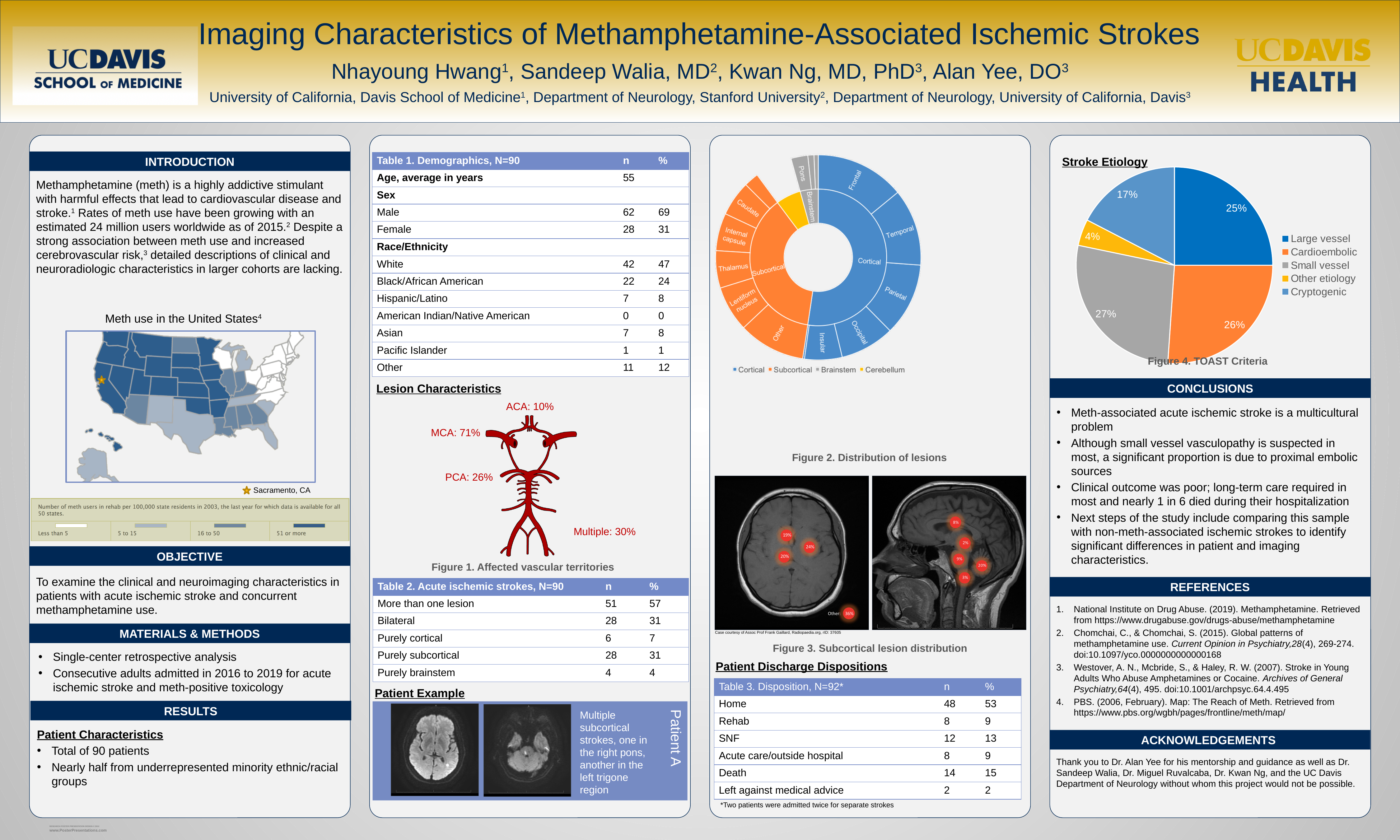
In the Stroke Etiology pie chart (Figure 4), which is larger, Cryptogenic or Other etiology? Cryptogenic How many categories does the legend of the Stroke Etiology pie chart (Figure 4) list? 5 In the Stroke Etiology pie chart (Figure 4), what share is Large vessel? 25% In Figure 2 (Distribution of lesions), which inner-ring category occupies the largest portion of the chart? Cortical In the Stroke Etiology pie chart (Figure 4), what share is Cardioembolic? 26% What kind of chart is Figure 4 (Stroke Etiology)? Pie chart In the Stroke Etiology pie chart (Figure 4), what is the difference in percentage points between Small vessel and Other etiology? 23 In the Stroke Etiology pie chart (Figure 4), what share is Small vessel? 27% How many categories does the legend of Figure 2 (Distribution of lesions) list? 4 In the Stroke Etiology pie chart (Figure 4), what share is Cryptogenic? 17% In the Stroke Etiology pie chart (Figure 4), which etiology has the smallest share? Other etiology In the Stroke Etiology pie chart (Figure 4), what colour is the Cardioembolic slice? Orange